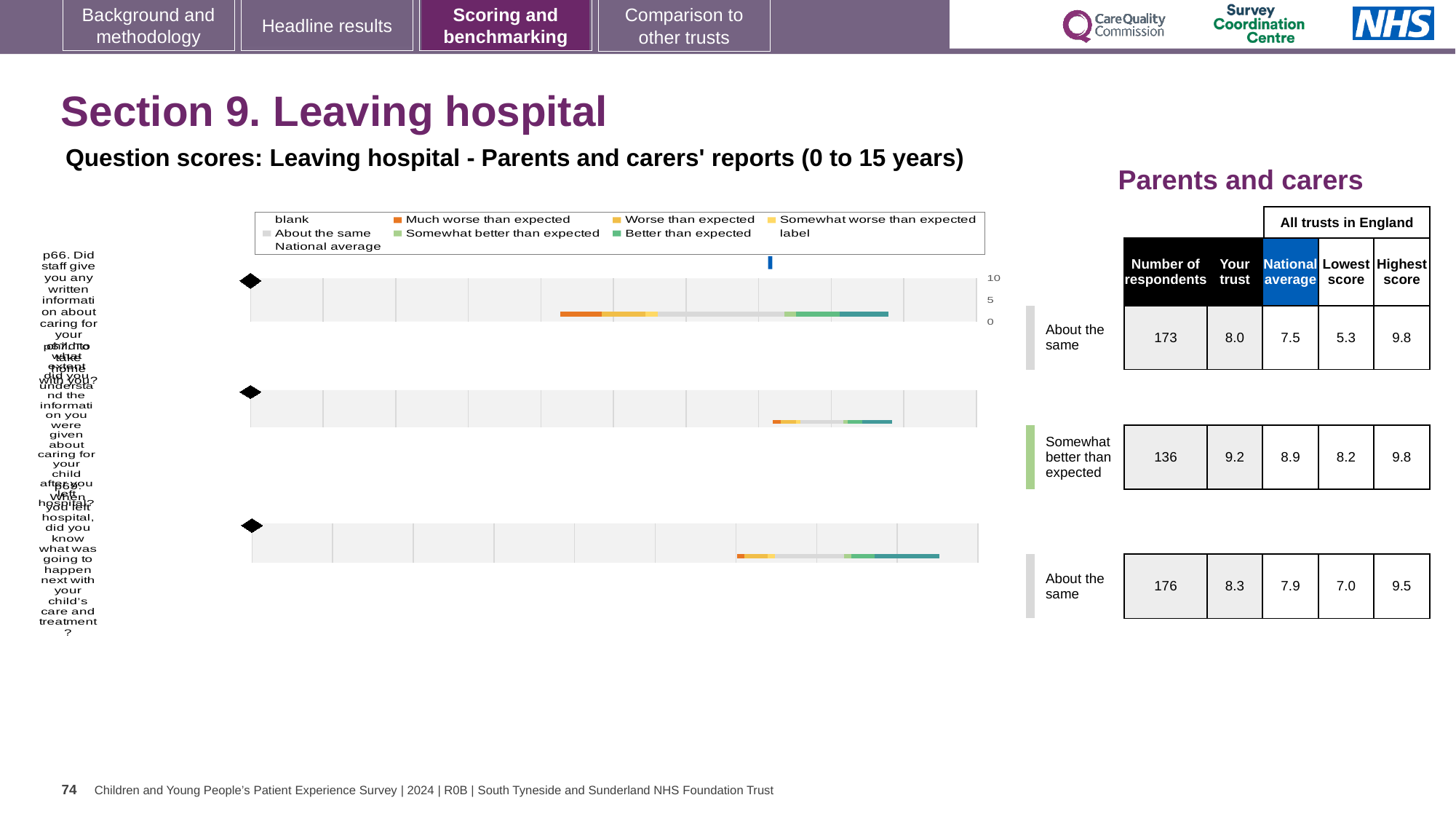
How many question bars are plotted in the chart? 3 In the table beside the chart, how many respondents are listed for the first row? 173 How many entries does the chart legend list? 9 In the table beside the chart, what is the 'Your trust' score for the second row (Somewhat better than expected)? 9.2 What kind of chart is shown on the slide? bar chart For the first row of the table, which is larger: the 'Your trust' score or the national average? Your trust (8.0) Which row in the table has the fewest respondents? the second row (Somewhat better than expected), 136 Which row in the table has the highest 'Your trust' score? the second row (Somewhat better than expected), 9.2 What is the highest score across all trusts in England for the first row of the table? 9.8 What is the lowest score across all trusts in England for the third row of the table? 7.0 What is the title of the chart? Question scores: Leaving hospital - Parents and carers' reports (0 to 15 years) For the second row of the table, what is the difference between the 'Your trust' score and the national average? 0.3